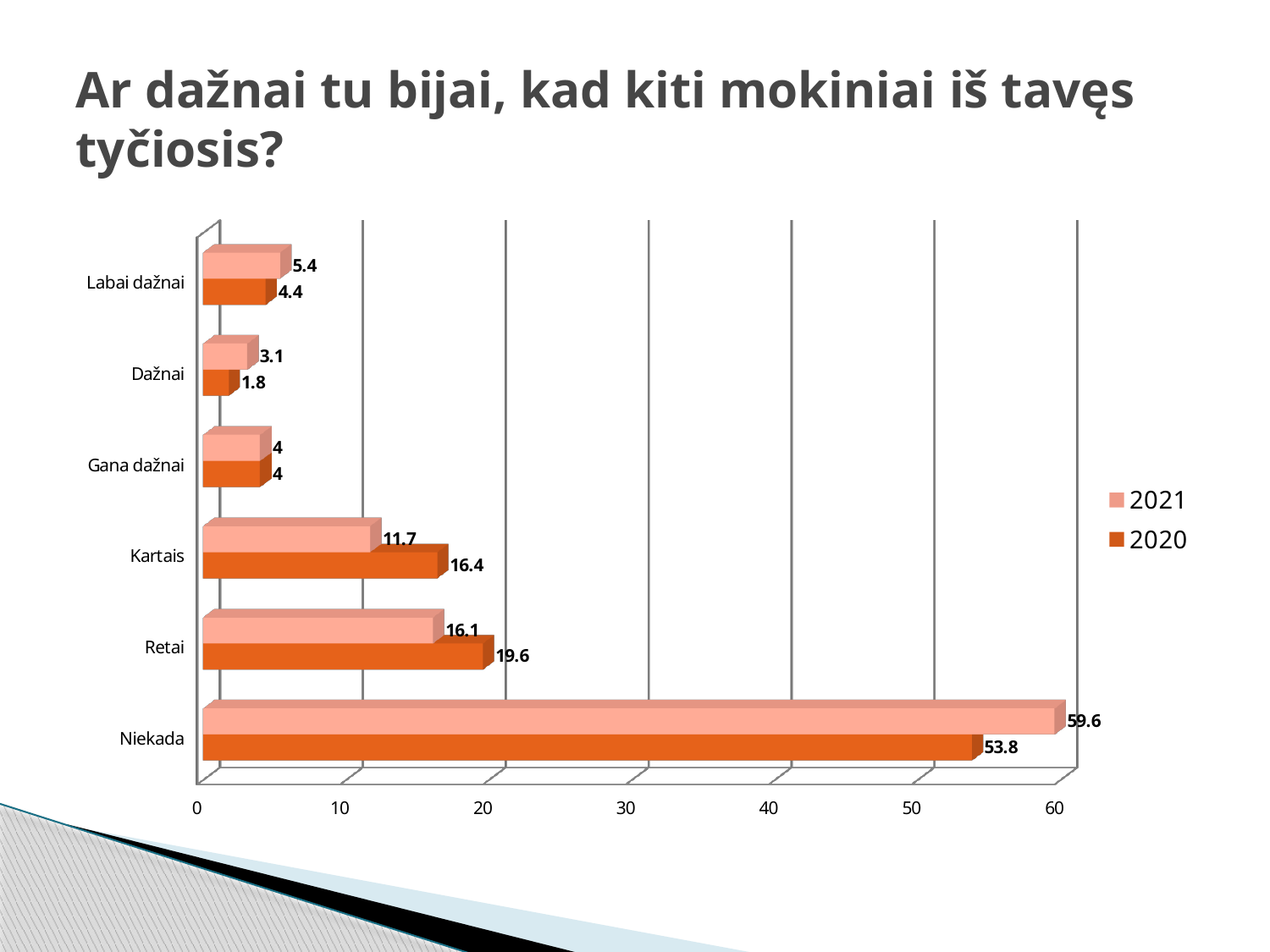
How many categories are shown on the chart? 6 Which category has the lowest value in the 2021 series? Dažnai How many series does the legend list? 2 What is the value for Kartais in the 2020 series? 16.4 What is the value for Dažnai in the 2020 series? 1.8 What is the value for Niekada in the 2021 series? 59.6 What kind of chart is shown on the slide? Bar chart Which is larger for Kartais, the 2021 value or the 2020 value? 2020 What is the difference between the 2020 and 2021 values for Retai? 3.5 Which series is shown in the lighter pink colour? 2021 What is the difference between the 2021 and 2020 values for Niekada? 5.8 Which category has the highest value in the 2020 series? Niekada